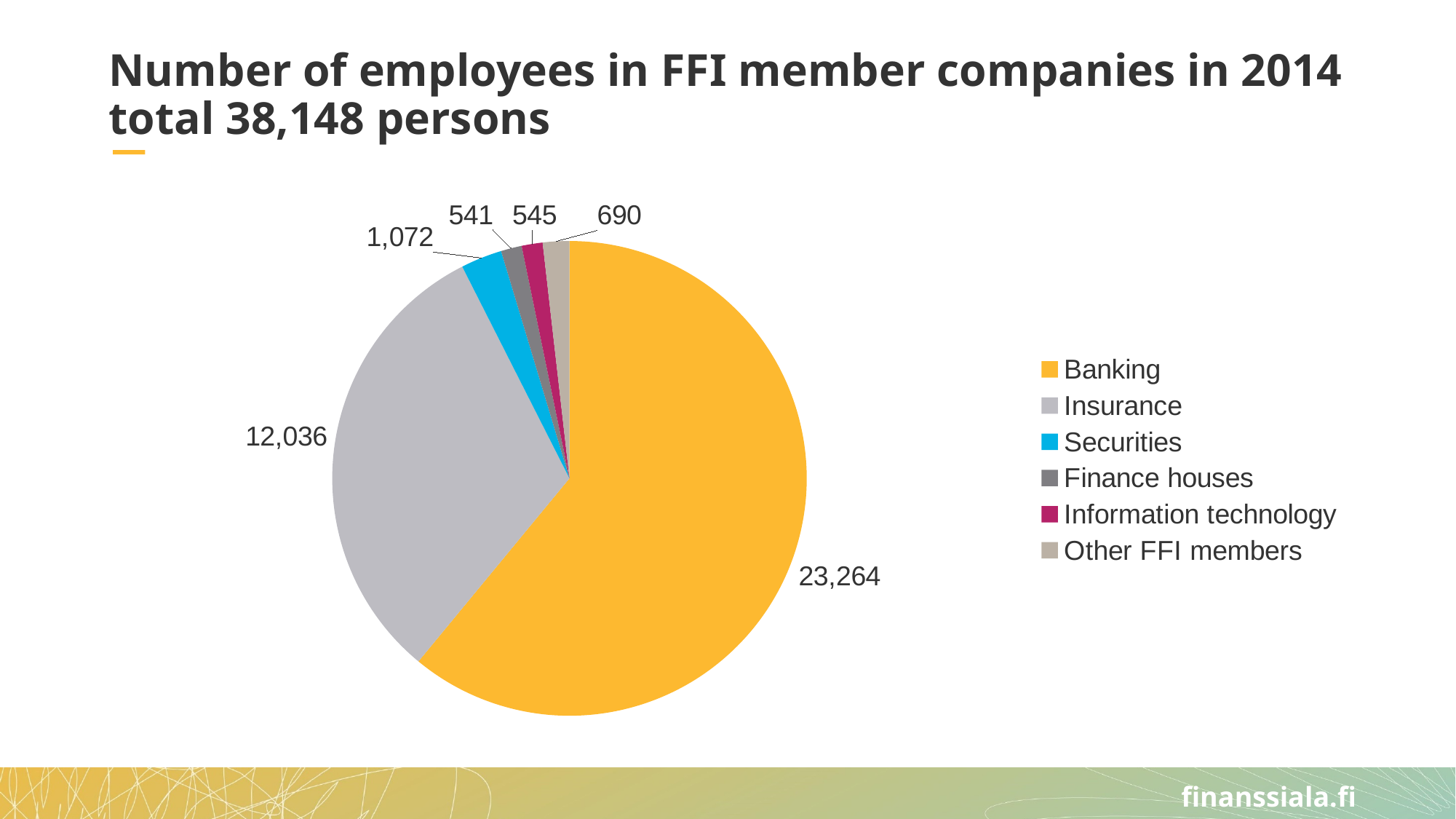
What type of chart is shown on the slide? Pie chart What colour is the Securities slice in the pie chart? Blue What share of the total does Banking represent, to the nearest whole percent? 61% What is the value for Securities in the pie chart? 1,072 Which category has the largest slice of the pie chart? Banking Which category has the smallest value in the pie chart? Finance houses How many employees are in Banking according to the pie chart? 23,264 What is the value for Insurance in the pie chart? 12,036 How many categories does the legend of the pie chart list? 6 What is the difference between the Banking and Insurance values? 11,228 Which is larger, the value for Information technology or the value for Finance houses? Information technology What is the value for Other FFI members in the pie chart? 690